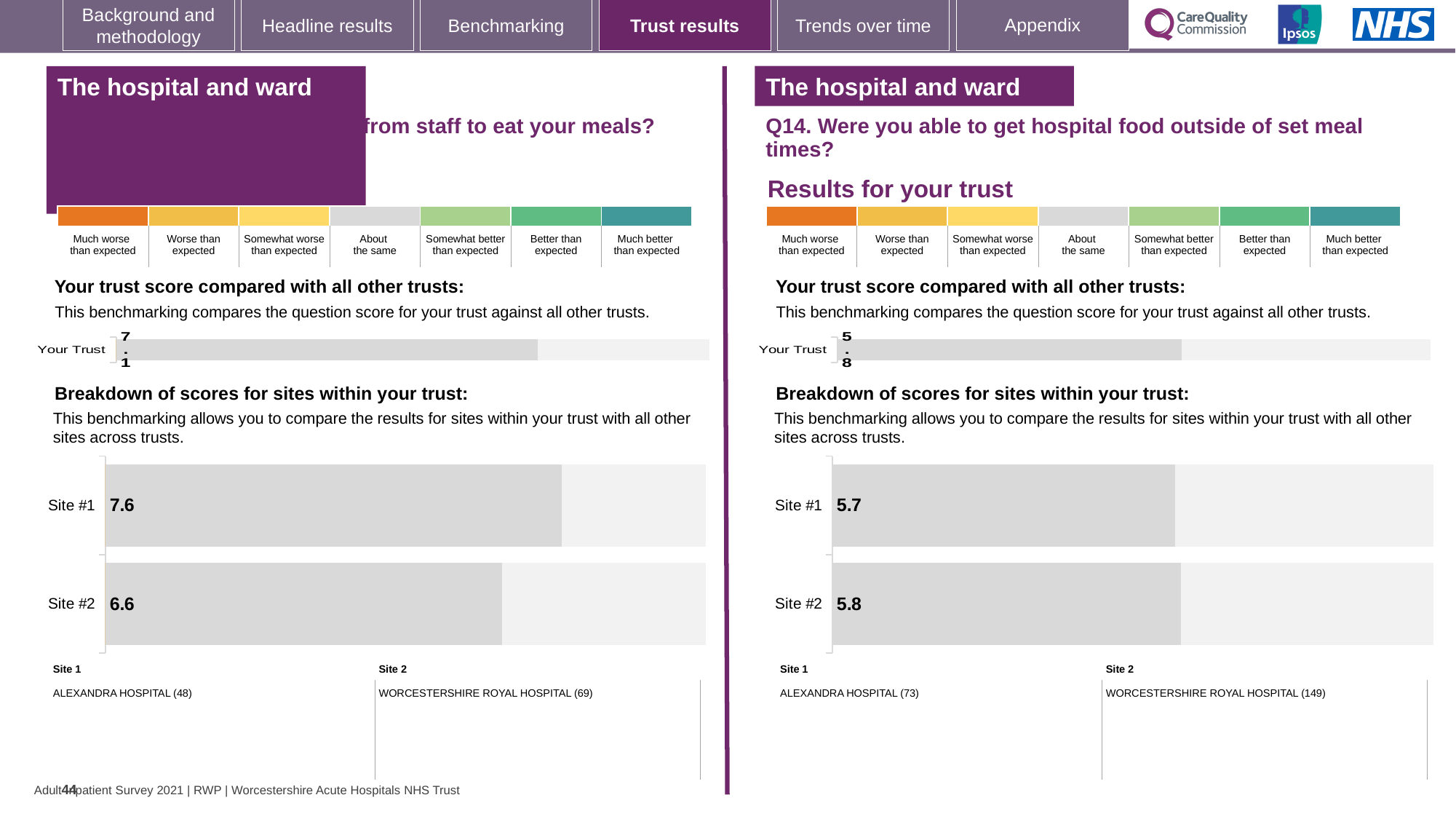
For Q14 (hospital food outside of set meal times), what is the difference between the Site #2 and Site #1 scores in the site breakdown chart? 0.1 On the left-hand side of the slide, what is the difference between the Site #1 and Site #2 scores in the site breakdown chart? 1.0 Is the Site #1 score for Q14 (hospital food outside of set meal times) larger or smaller than the Site #1 score on the left-hand side of the slide? Smaller How many sites are shown in the site breakdown chart for Q14 (hospital food outside of set meal times)? 2 For Q14 (hospital food outside of set meal times), what is the score shown for Site #2 in the site breakdown chart? 5.8 On the left-hand side of the slide, what is the score shown for Site #1 in the breakdown of scores for sites within your trust? 7.6 For Q14 (hospital food outside of set meal times), what is the score shown for Site #1 in the site breakdown chart? 5.7 On the left-hand side of the slide, which site has the higher score in the site breakdown chart? Site #1 On the left-hand side of the slide, what is the score shown for Site #2 in the breakdown of scores for sites within your trust? 6.6 What type of chart is used for the breakdown of scores for sites within your trust on the left-hand side of the slide? Bar chart On the left-hand side of the slide, what is the 'Your Trust' score in the trust score comparison chart? 7.1 For Q14 (hospital food outside of set meal times), what is the 'Your Trust' score in the trust score comparison chart? 5.8